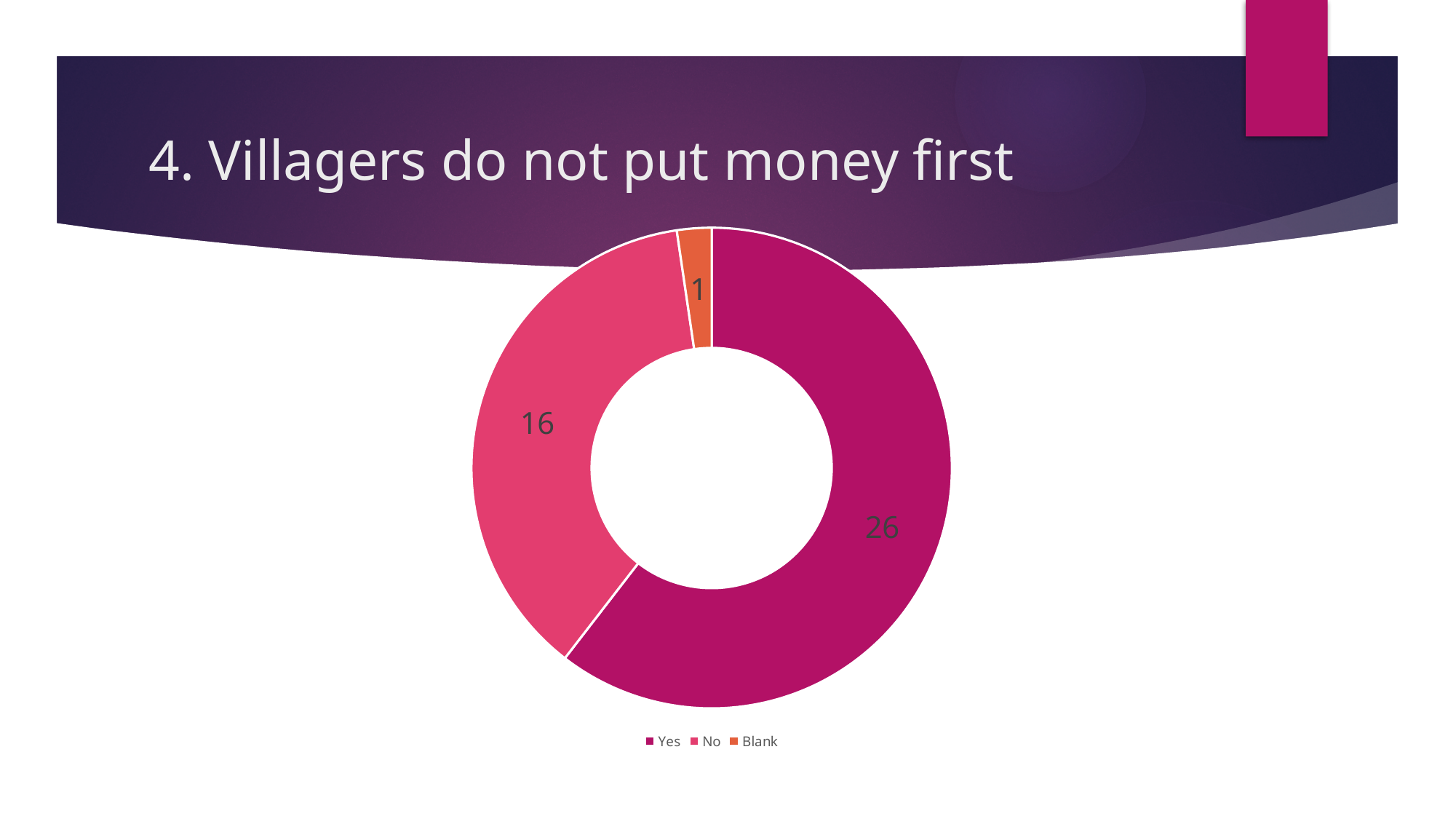
Which category has the highest value? Yes What is the total of all the values in the chart? 43 What is the title of the slide? 4. Villagers do not put money first Which legend entry is shown in orange? Blank What is the value for Yes? 26 How many categories does the chart show? 3 What is the value for Blank? 1 What kind of chart is shown on the slide? Doughnut chart What is the difference between the values for Yes and No? 10 What is the value for No? 16 Which is larger, the value for No or the value for Blank? No Which category has the lowest value? Blank